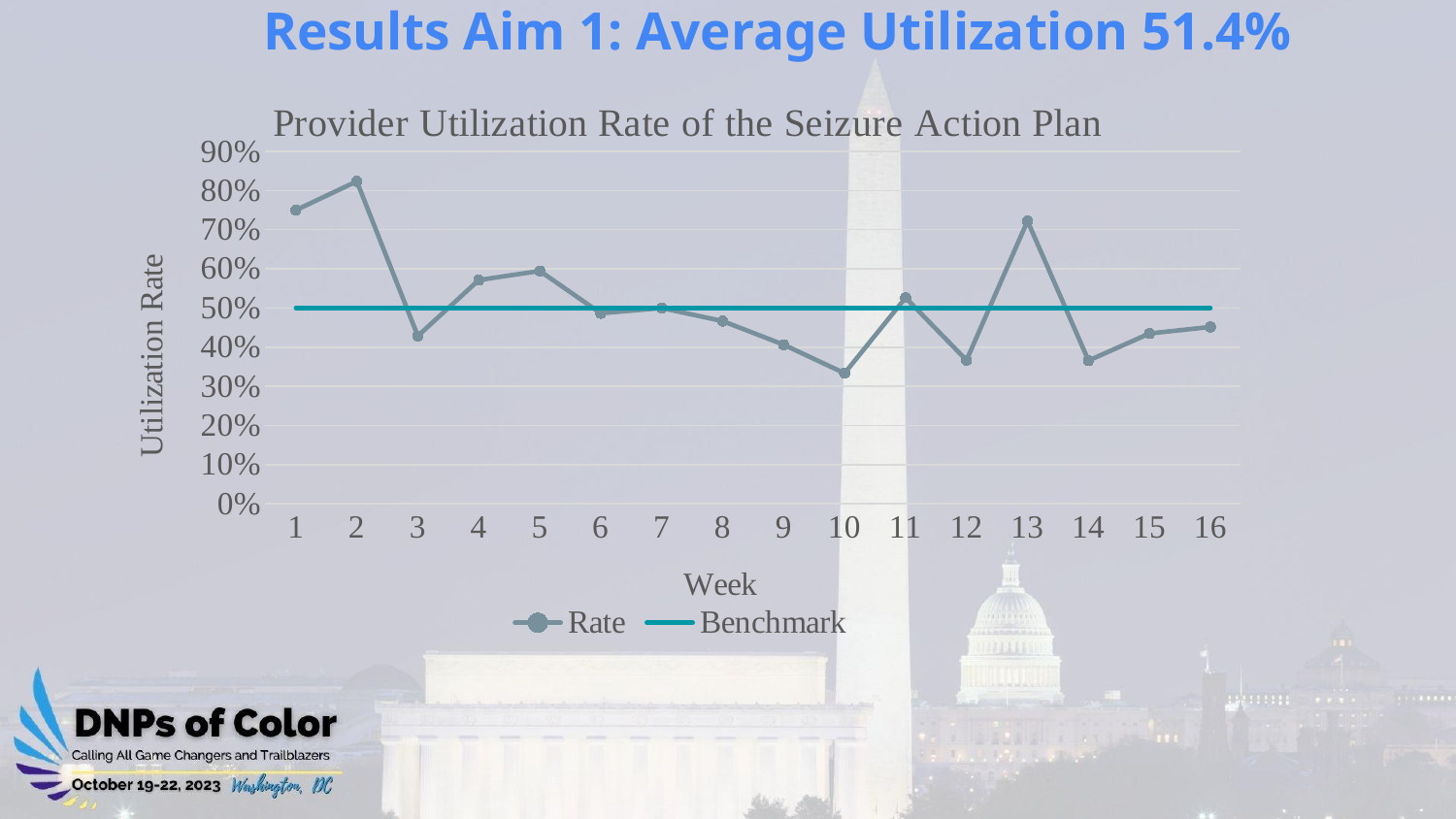
Which week has the higher Rate, week 2 or week 13? Week 2 What is the title of the chart? Provider Utilization Rate of the Seizure Action Plan Does the Rate rise or fall from week 1 to week 3? Fall How many series does the legend list? 2 In which week is the Rate lowest? Week 10 Is the Rate for week 10 greater or less than 40%? less Is the Rate for week 13 greater or less than 60%? greater What type of chart is shown on the slide? Line chart How many weeks are plotted on the x axis? 16 Is the Rate for week 1 greater or less than 70%? greater In which week is the Rate highest? Week 2 What value is the Benchmark line set at? 50%